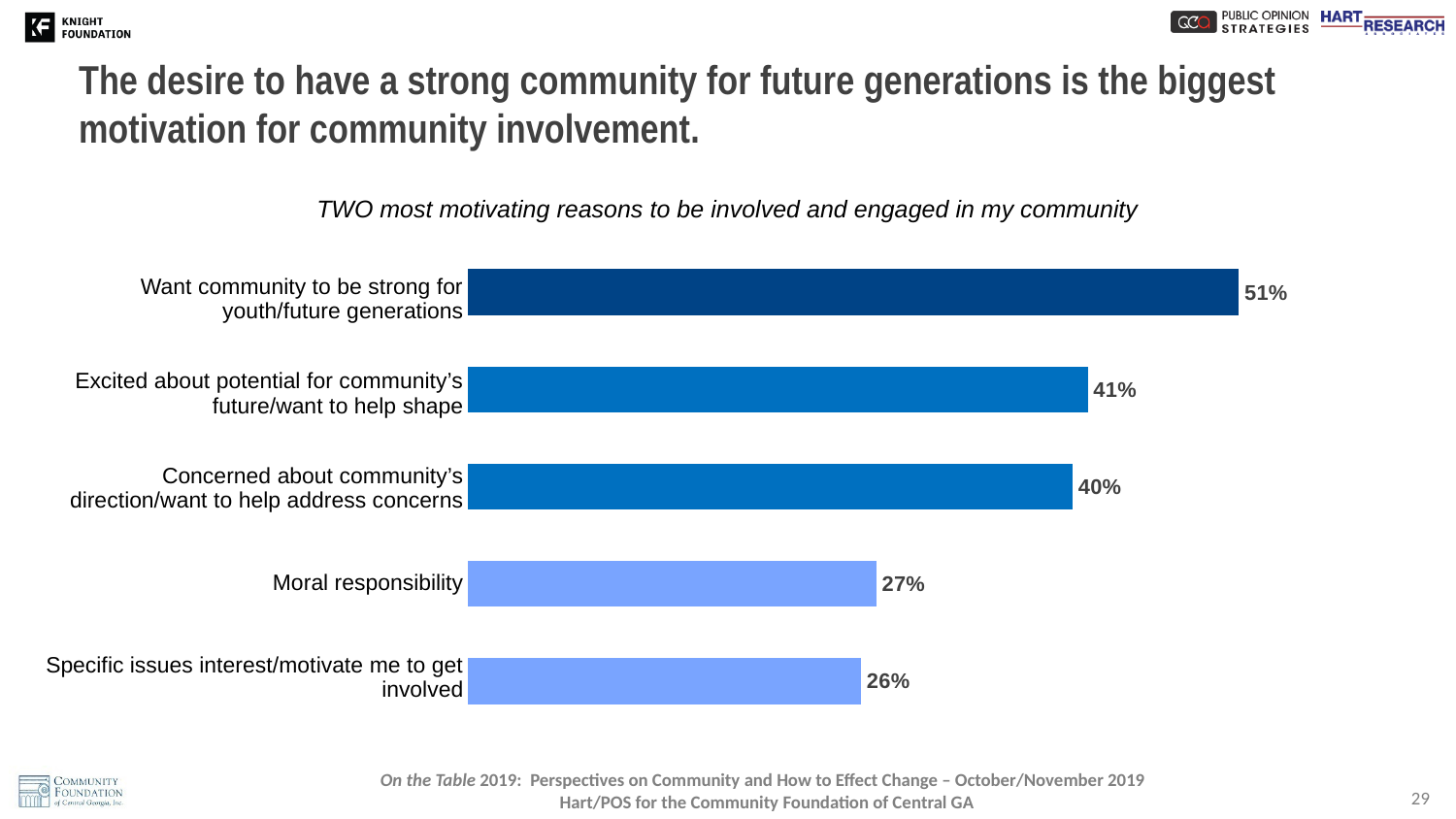
What percentage chose 'Want community to be strong for youth/future generations' as a motivating reason? 51% How many reasons are shown in the chart? 5 Which is larger: the value for 'Excited about potential for community's future/want to help shape' or for 'Moral responsibility'? Excited about potential for community's future/want to help shape Do the values increase or decrease from the top bar to the bottom bar? Decrease What is the difference between 'Excited about potential for community's future/want to help shape' and 'Concerned about community's direction/want to help address concerns'? 1 percentage point What percentage is shown for 'Specific issues interest/motivate me to get involved'? 26% Which reason has the highest percentage? Want community to be strong for youth/future generations What is the difference in percentage points between 'Want community to be strong for youth/future generations' and 'Moral responsibility'? 24 Which reason has the lowest percentage? Specific issues interest/motivate me to get involved What is the value for 'Moral responsibility'? 27% What type of chart is shown on the slide? Bar chart What is the subtitle of the chart? TWO most motivating reasons to be involved and engaged in my community